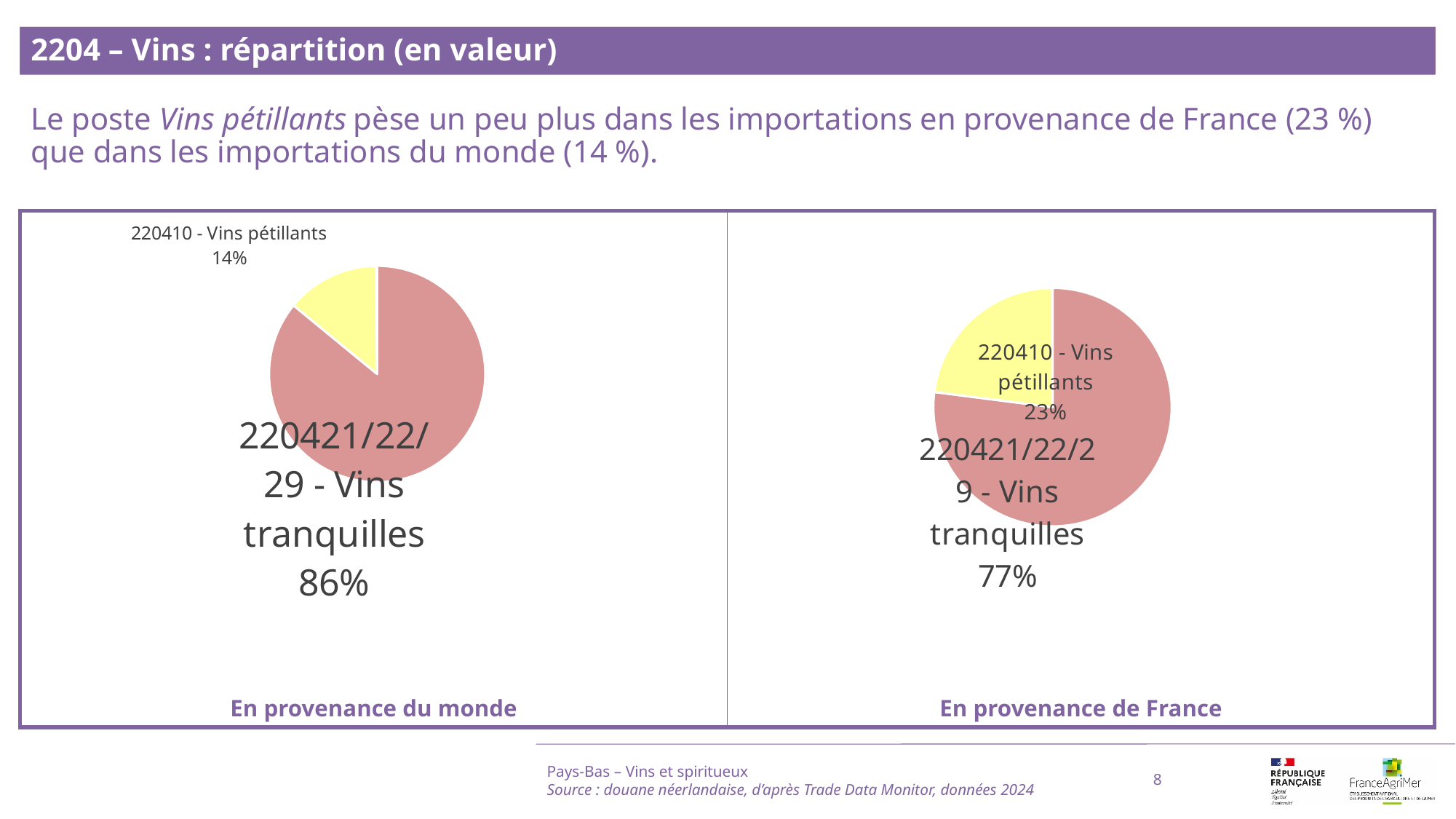
Is the share of Vins pétillants larger in the 'En provenance du monde' chart or in the 'En provenance de France' chart? En provenance de France In the 'En provenance du monde' chart, what is the difference between the shares of Vins tranquilles and Vins pétillants? 72% In the 'En provenance de France' chart, what share does '220421/22/29 - Vins tranquilles' have? 77% In the 'En provenance du monde' chart, what share does '220421/22/29 - Vins tranquilles' have? 86% In the 'En provenance de France' chart, which category has the smallest slice? 220410 - Vins pétillants What type of chart is used in the 'En provenance du monde' panel? Pie chart In the 'En provenance du monde' chart, which category has the largest slice? 220421/22/29 - Vins tranquilles In the 'En provenance du monde' chart, what share does '220410 - Vins pétillants' have? 14% In the 'En provenance de France' chart, what is the difference between the shares of Vins tranquilles and Vins pétillants? 54% In the 'En provenance du monde' chart, what colour is the Vins pétillants slice? Yellow How many categories are shown in the 'En provenance de France' chart? 2